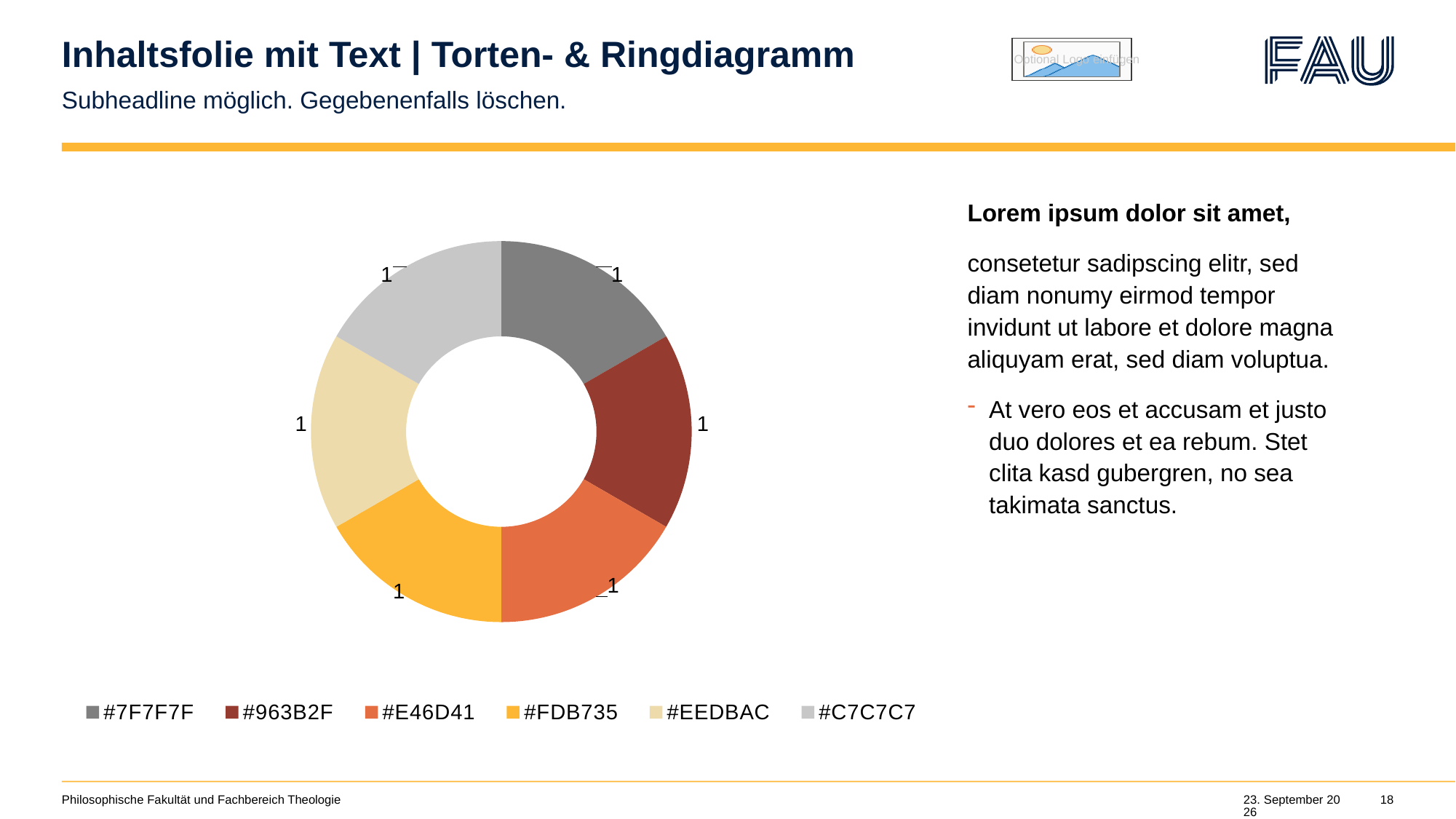
What kind of chart is shown on the slide? doughnut chart How many entries does the legend of the doughnut chart list? 6 Which legend entry is shown in the darkest grey colour? #7F7F7F What is the value of the #FDB735 slice in the doughnut chart? 1 What is the total of all slice values in the doughnut chart? 6 What is the difference between the values of the #963B2F and #E46D41 slices? 0 What is the first entry listed in the chart legend? #7F7F7F What is the value of the #7F7F7F slice in the doughnut chart? 1 Do all slices of the doughnut chart have the same value? yes What is the value of the #C7C7C7 slice in the doughnut chart? 1 What share of the doughnut does the #EEDBAC slice represent? one sixth How many slices does the doughnut chart have? 6